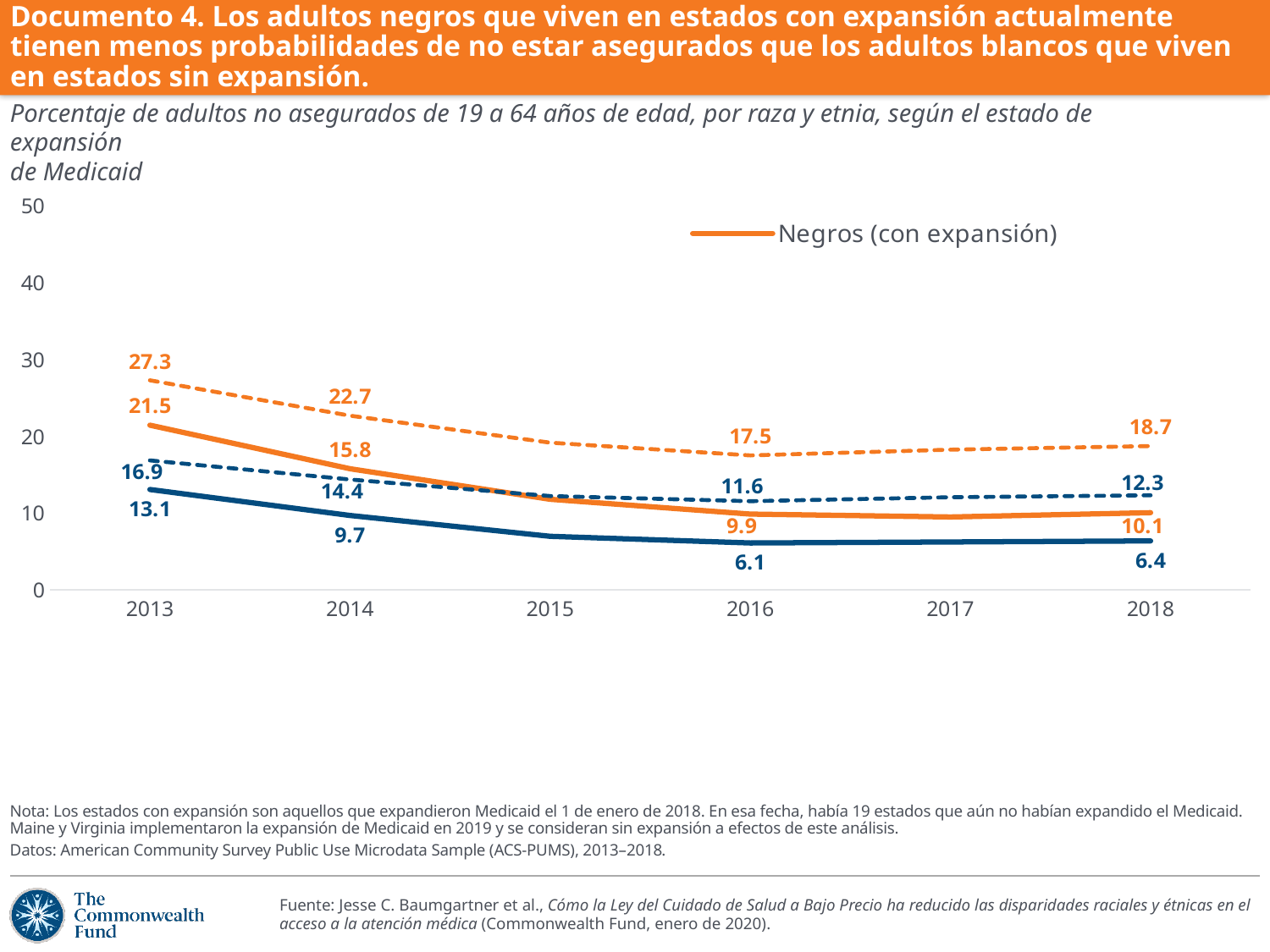
What is the difference between the Negros (con expansión) values for 2013 and 2014? 5.7 Does the value for Negros (con expansión) rise or fall from 2013 to 2016? fall What is the value for Negros (con expansión) in 2014? 15.8 What is the value for Negros (con expansión) in 2018? 10.1 What is the value for Negros (con expansión) in 2016? 9.9 For Negros (con expansión), which year has the larger value, 2016 or 2018? 2018 How many years are shown on the x axis? 6 In which year is the value for Negros (con expansión) highest? 2013 What is the value for Negros (con expansión) in 2013? 21.5 What kind of chart is shown on the slide? line chart By how much did the value for Negros (con expansión) fall from 2013 to 2018? 11.4 Is the value for Negros (con expansión) in 2015 greater or less than 20? less